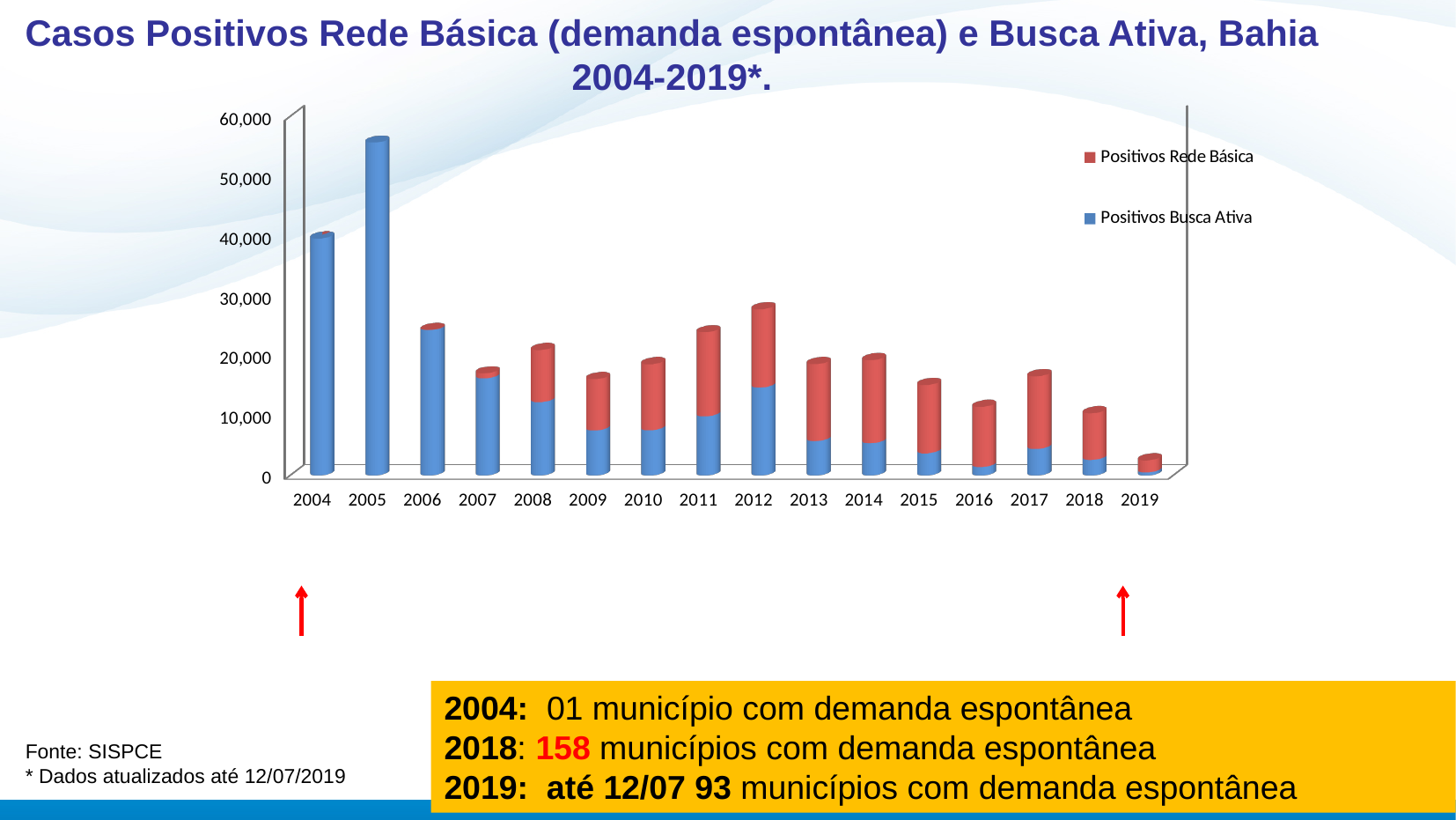
Is the total value for 2012 greater or less than 30,000? less Is the total value for 2006 greater or less than 20,000? greater Which year has a larger total bar, 2012 or 2013? 2012 How many years are shown on the x axis of the chart? 16 Is the total value for 2005 greater or less than 50,000? greater How many series does the chart's legend list? 2 Which year has the highest total bar in the chart? 2005 Which series is shown in red in the chart's legend? Positivos Rede Básica Which year has a larger total bar, 2004 or 2005? 2005 Which year has the lowest total bar in the chart? 2019 What kind of chart is shown on the slide? Stacked bar chart